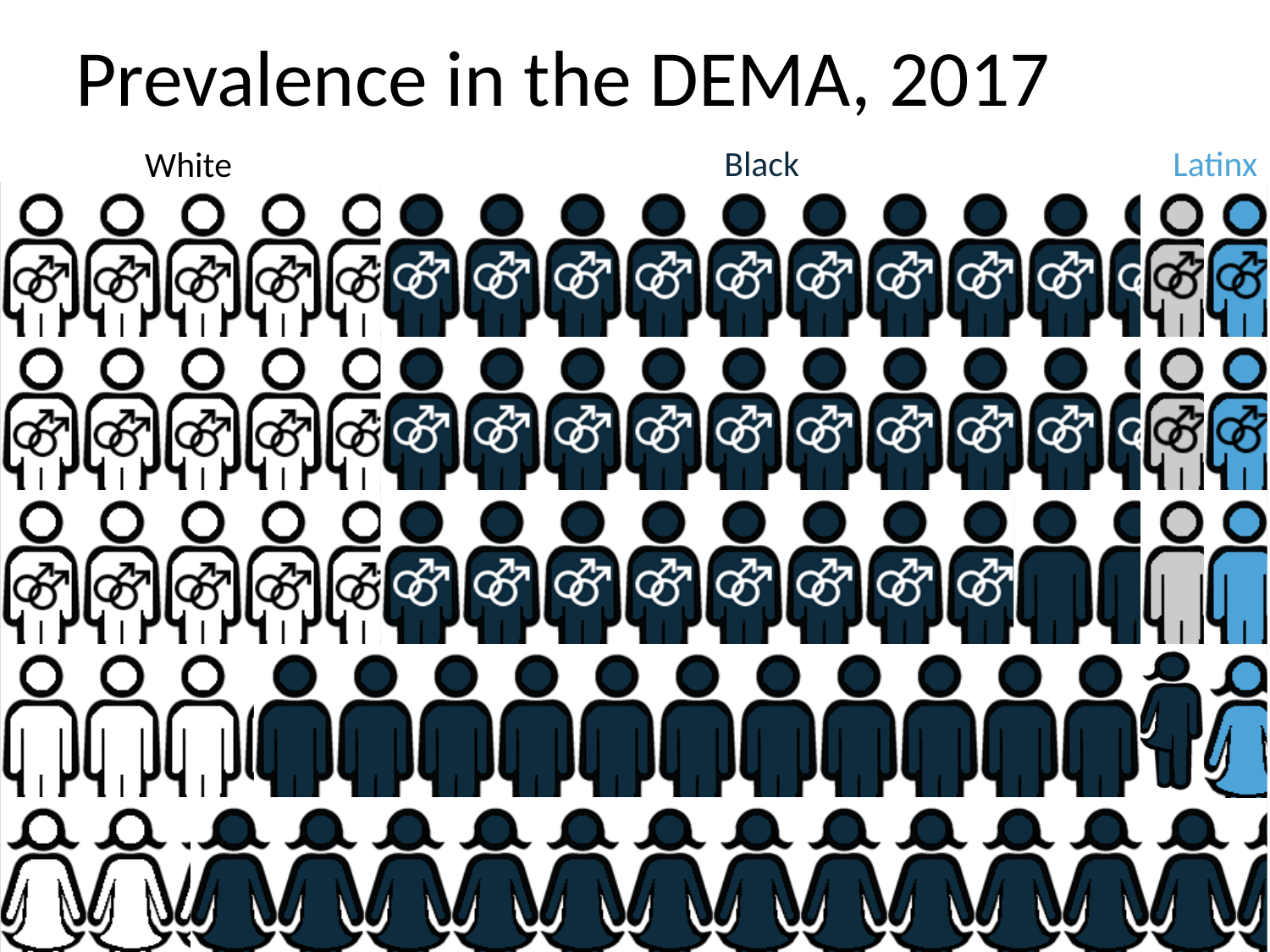
How many groups are labelled in the chart? 3 Which group is represented by the largest number of person icons? Black What kind of chart is shown on the slide? pictogram (icon array) What colour are the icons representing the Latinx group? light blue Which group is represented by the smallest number of person icons? Latinx What is the title of the chart on the slide? Prevalence in the DEMA, 2017 Which groups are labelled across the top of the chart? White, Black, Latinx Which group has more person icons, White or Latinx? White Which group has more person icons, Black or White? Black